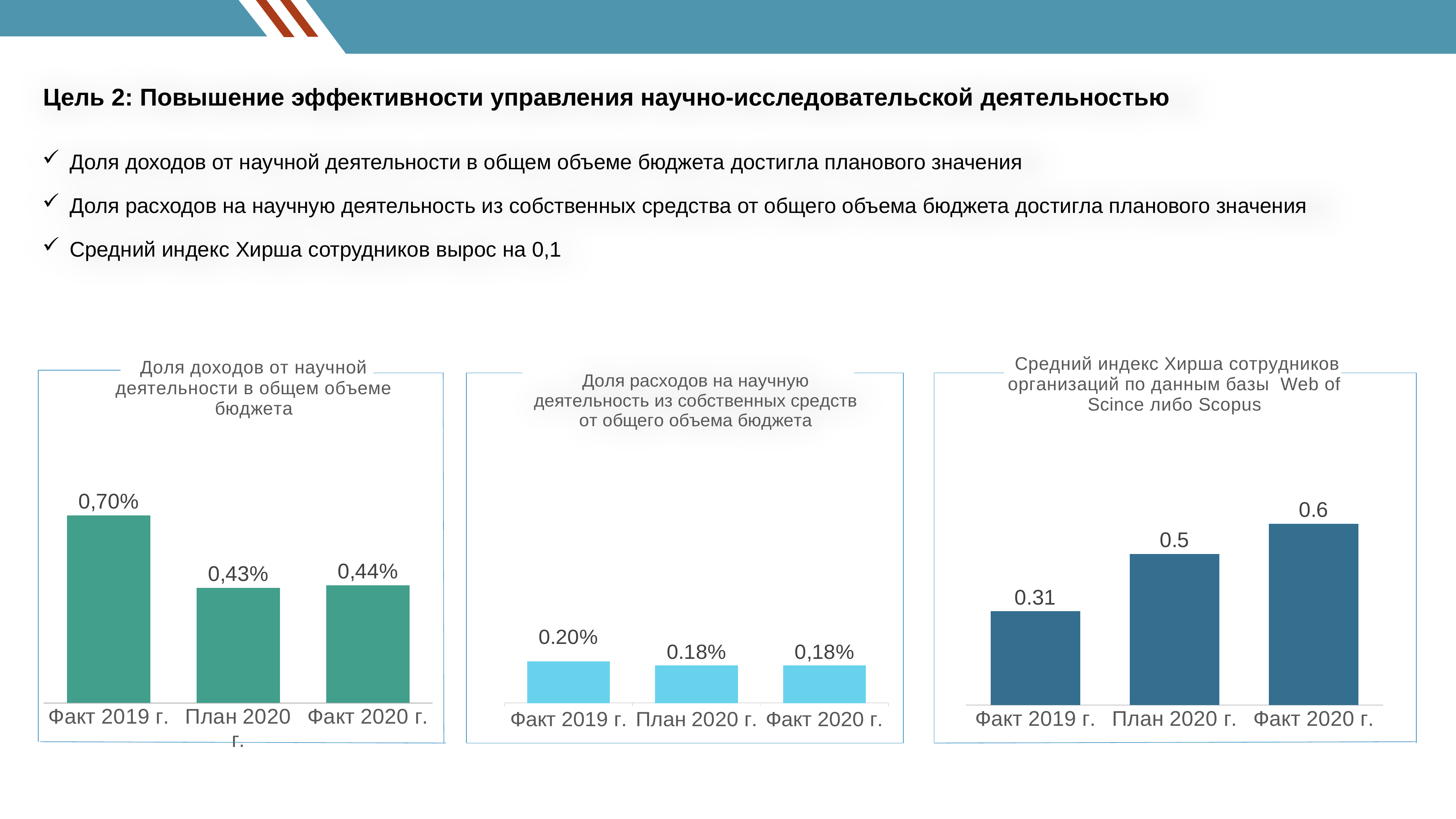
In the right chart (Средний индекс Хирша сотрудников), what is the value for Факт 2019 г.? 0.31 In the left chart (Доля доходов от научной деятельности в общем объеме бюджета), which category has the lowest value? План 2020 г. In the left chart (Доля доходов от научной деятельности в общем объеме бюджета), what is the value for Факт 2019 г.? 0,70% In the right chart (Средний индекс Хирша сотрудников), do the values rise or fall from Факт 2019 г. to Факт 2020 г.? rise In the left chart (Доля доходов от научной деятельности в общем объеме бюджета), what is the value for Факт 2020 г.? 0,44% In the middle chart (Доля расходов на научную деятельность из собственных средств от общего объема бюджета), what is the value for План 2020 г.? 0.18% In the right chart (Средний индекс Хирша сотрудников), what is the difference between Факт 2020 г. and План 2020 г.? 0.1 In the middle chart (Доля расходов на научную деятельность из собственных средств от общего объема бюджета), what is the value for Факт 2019 г.? 0.20% In the middle chart (Доля расходов на научную деятельность из собственных средств от общего объема бюджета), how many bars are plotted? 3 In the left chart (Доля доходов от научной деятельности в общем объеме бюджета), which category has the highest value? Факт 2019 г. In the right chart (Средний индекс Хирша сотрудников), what is the value for Факт 2020 г.? 0.6 What type of chart is the right chart (Средний индекс Хирша сотрудников)? bar chart